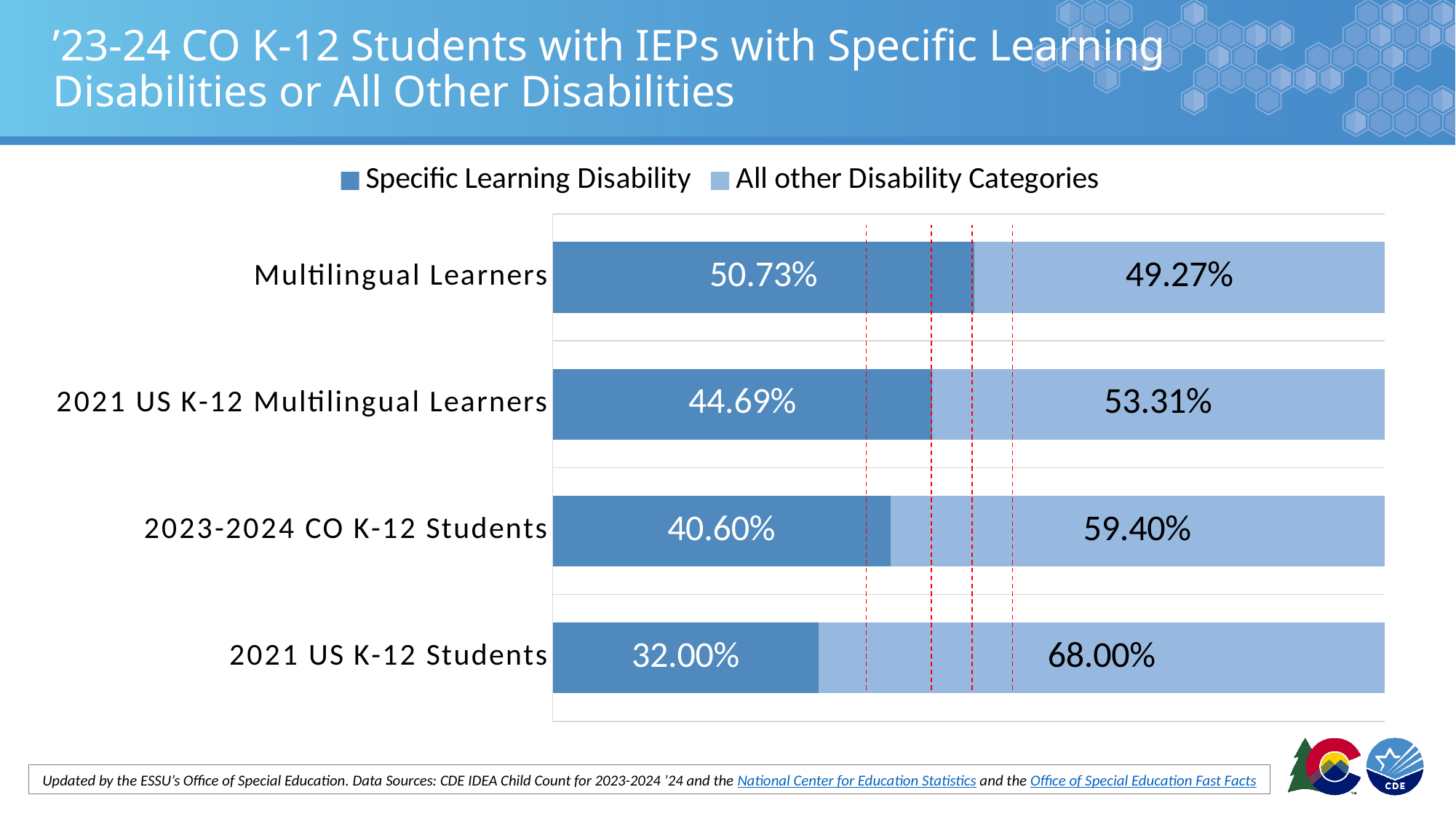
What is the All other Disability Categories value for 2021 US K-12 Students? 68.00% What is the Specific Learning Disability value for 2023-2024 CO K-12 Students? 40.60% How many series does the legend list? 2 Which category has the lowest Specific Learning Disability value? 2021 US K-12 Students What is the All other Disability Categories value for 2021 US K-12 Multilingual Learners? 53.31% Which is larger: the Specific Learning Disability value for 2021 US K-12 Multilingual Learners or for 2023-2024 CO K-12 Students? 2021 US K-12 Multilingual Learners How many categories are shown on the chart? 4 What is the total of the stacked bar for 2023-2024 CO K-12 Students? 100.00% Which category has the highest Specific Learning Disability value? Multilingual Learners What is the difference between the Specific Learning Disability values for Multilingual Learners and 2021 US K-12 Students? 18.73% What kind of chart is shown on the slide? Stacked bar chart What is the Specific Learning Disability value for Multilingual Learners? 50.73%